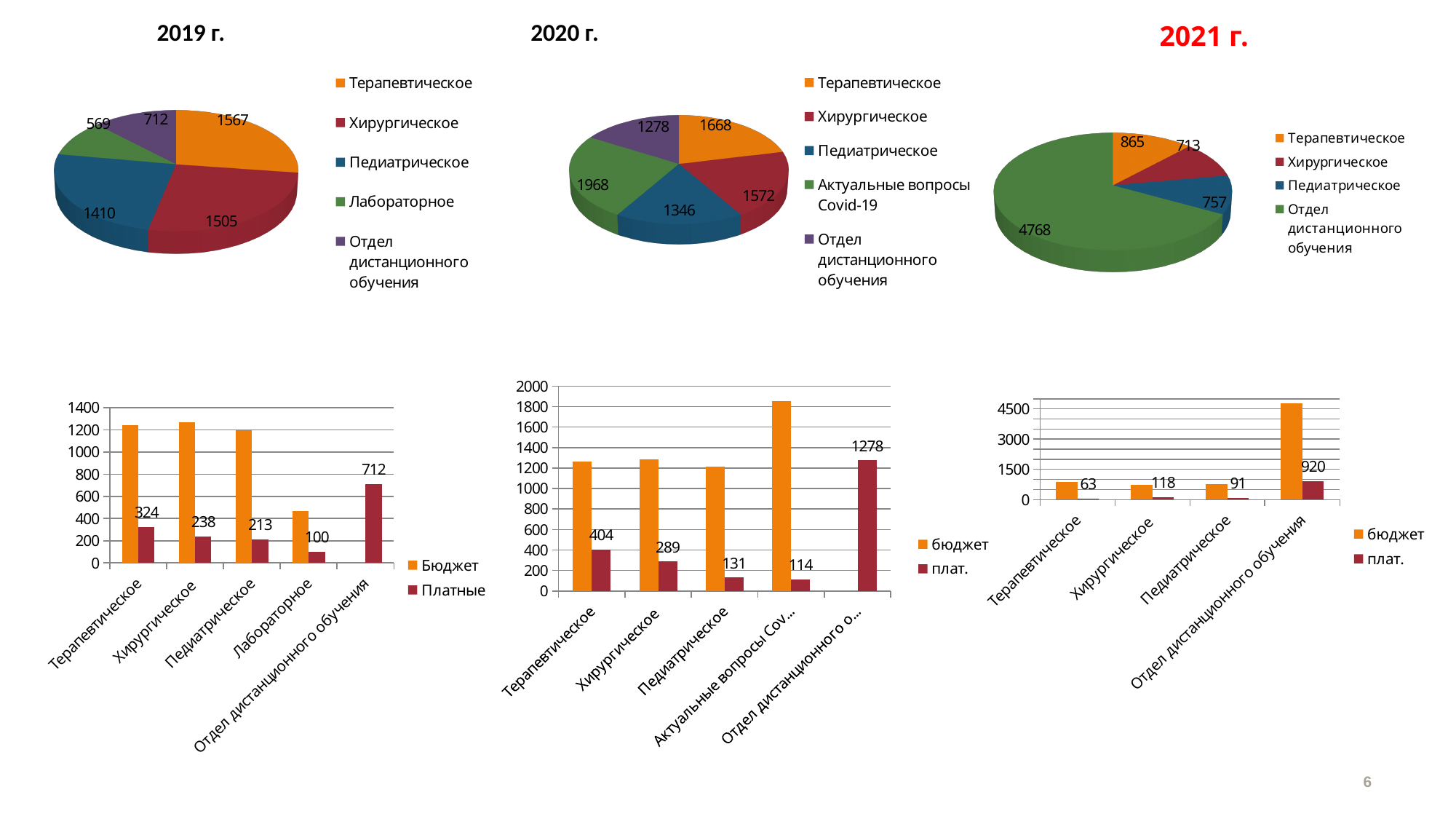
In the bar chart under 2019 г., is the Бюджет value for Терапевтическое greater or less than 1000? greater In the 2019 г. pie chart, which category has the smallest value? Лабораторное How many series does the legend of the bar chart under 2020 г. list? 2 In the bar chart under 2020 г., what is the плат. value for Отдел дистанционного обучения? 1278 How many categories does the 2020 г. pie chart legend list? 5 In the bar chart under 2021 г., what is the плат. value for Хирургическое? 118 In the 2021 г. pie chart, which is larger: Хирургическое or Педиатрическое? Педиатрическое In the 2020 г. pie chart, what is the difference between Терапевтическое and Хирургическое? 96 In the 2021 г. pie chart, what is the value for Отдел дистанционного обучения? 4768 In the 2020 г. pie chart, which category has the largest value? Актуальные вопросы Covid-19 In the bar chart under 2019 г., what is the Платные value for Терапевтическое? 324 In the 2019 г. pie chart, what is the value for Педиатрическое? 1410